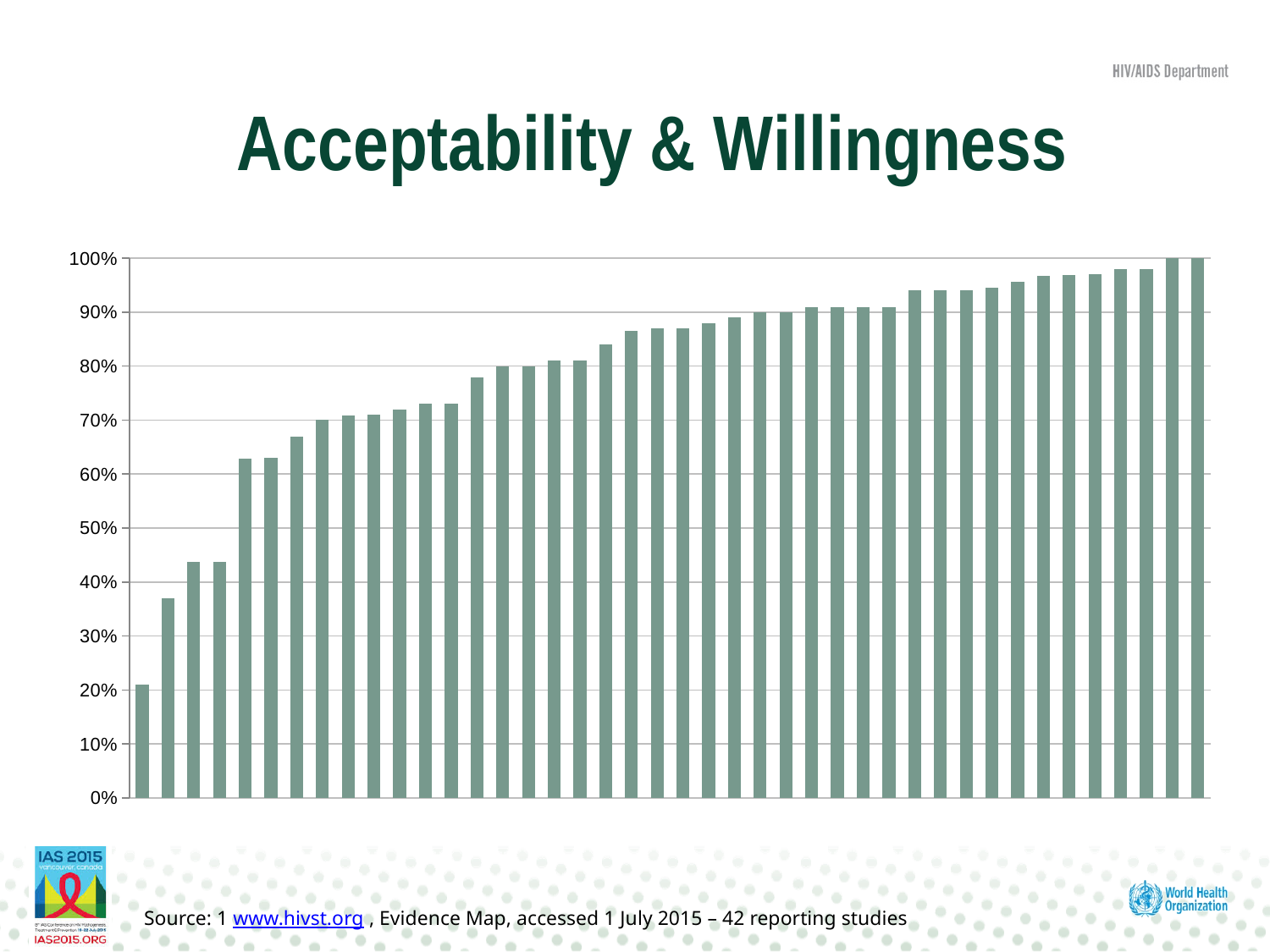
Is the value of the leftmost bar greater or less than 30%? less Which is larger, the value of the leftmost bar or the value of the rightmost bar? rightmost bar Is the value of the rightmost bar greater or less than 90%? greater What is the highest value shown on the y axis of the chart? 100% Which bar has the lowest value, the leftmost or the rightmost? leftmost Is the value of the second bar from the left greater or less than 40%? less Do the bar values rise or fall from left to right across the chart? rise What value do the tallest bars on the right of the chart reach on the y axis? 100% What kind of chart is shown on the slide? bar chart What is the title of the chart on the slide? Acceptability & Willingness